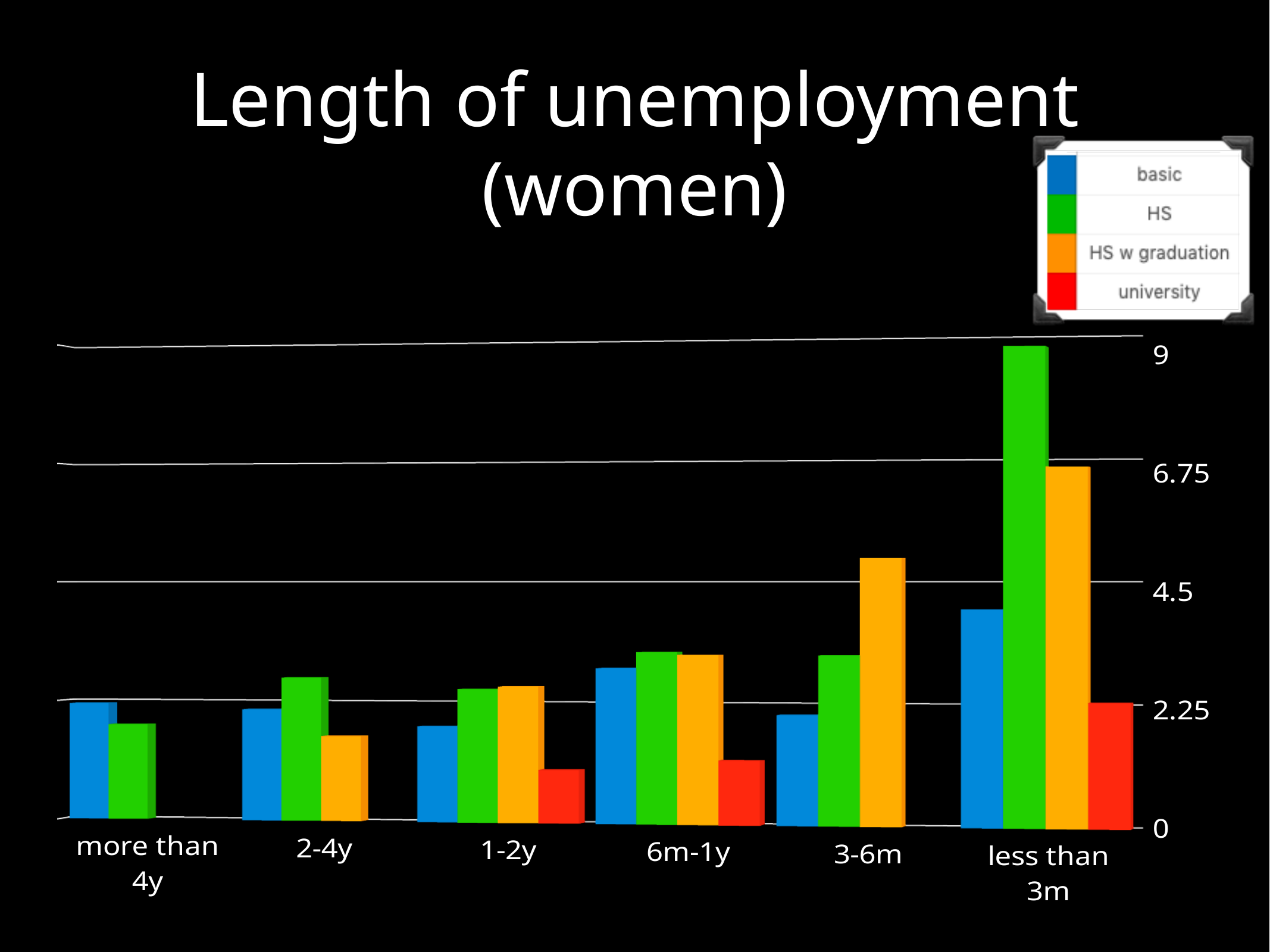
Which colour represents the 'university' series in the legend? red Is the value for university in the '1-2y' category greater or less than 2.25? less Which category contains the tallest bar in the chart? less than 3m How many unemployment-length categories are shown on the x axis? 6 How many series does the legend list? 4 Is the value for HS w graduation in the '3-6m' category greater or less than 4.5? greater Which series has the lowest bar in the '6m-1y' category? university In the '2-4y' category, which is larger: HS or HS w graduation? HS In the '3-6m' category, which is larger: basic or HS w graduation? HS w graduation Is the value for basic in the 'less than 3m' category greater or less than 4.5? less What kind of chart is shown on the slide? bar chart Which series has the tallest bar in the 'less than 3m' category? HS